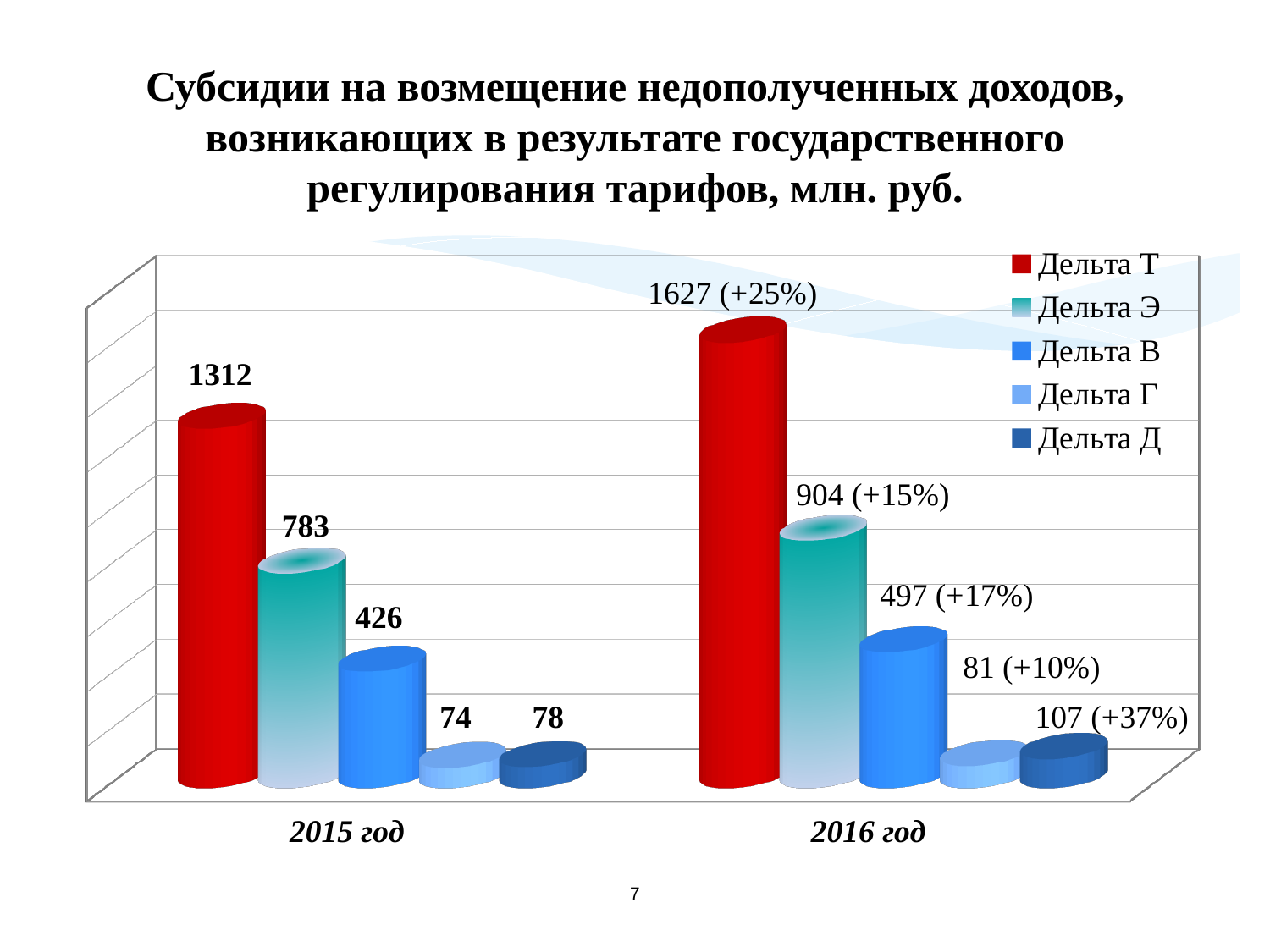
What is the value for Дельта Д in 2015 год? 78 What percentage change is shown next to the Дельта Д value for 2016 год? +37% What kind of chart is shown on the slide? Bar chart What is the value for Дельта Г in 2016 год? 81 How many series does the legend list? 5 Which series has the lowest value in 2015 год? Дельта Г What is the value for Дельта Т in 2015 год? 1312 What is the difference between the Дельта Т values for 2016 год and 2015 год? 315 What is the value for Дельта Э in 2016 год? 904 Which is larger: Дельта В in 2015 год or Дельта В in 2016 год? Дельта В in 2016 год Which series has the highest value in 2016 год? Дельта Т How many categories are shown on the x axis? 2